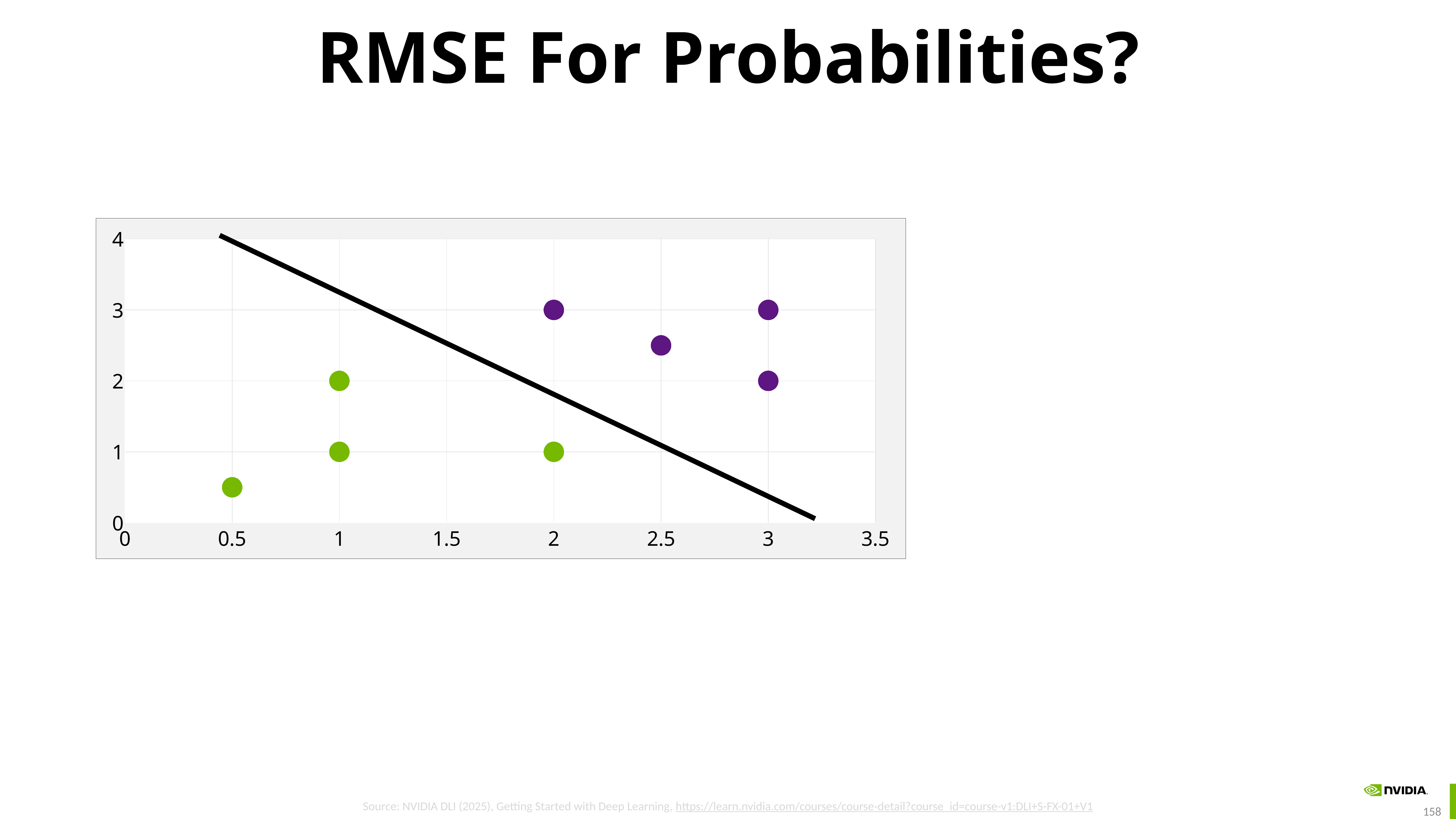
How many points are plotted on the chart in total? 8 How many purple points are plotted on the chart? 4 What kind of chart is shown on the slide? scatter chart What is the y value of the green point at x = 2? 1 Which is larger: the y value of the purple point at x = 2 or the y value of the green point at x = 2? the purple point at x = 2 What is the maximum value shown on the y axis? 4 How many green points are plotted on the chart? 4 Is the y value of the purple point at x = 2.5 greater or less than 2? greater What is the highest y value reached by any purple point? 3